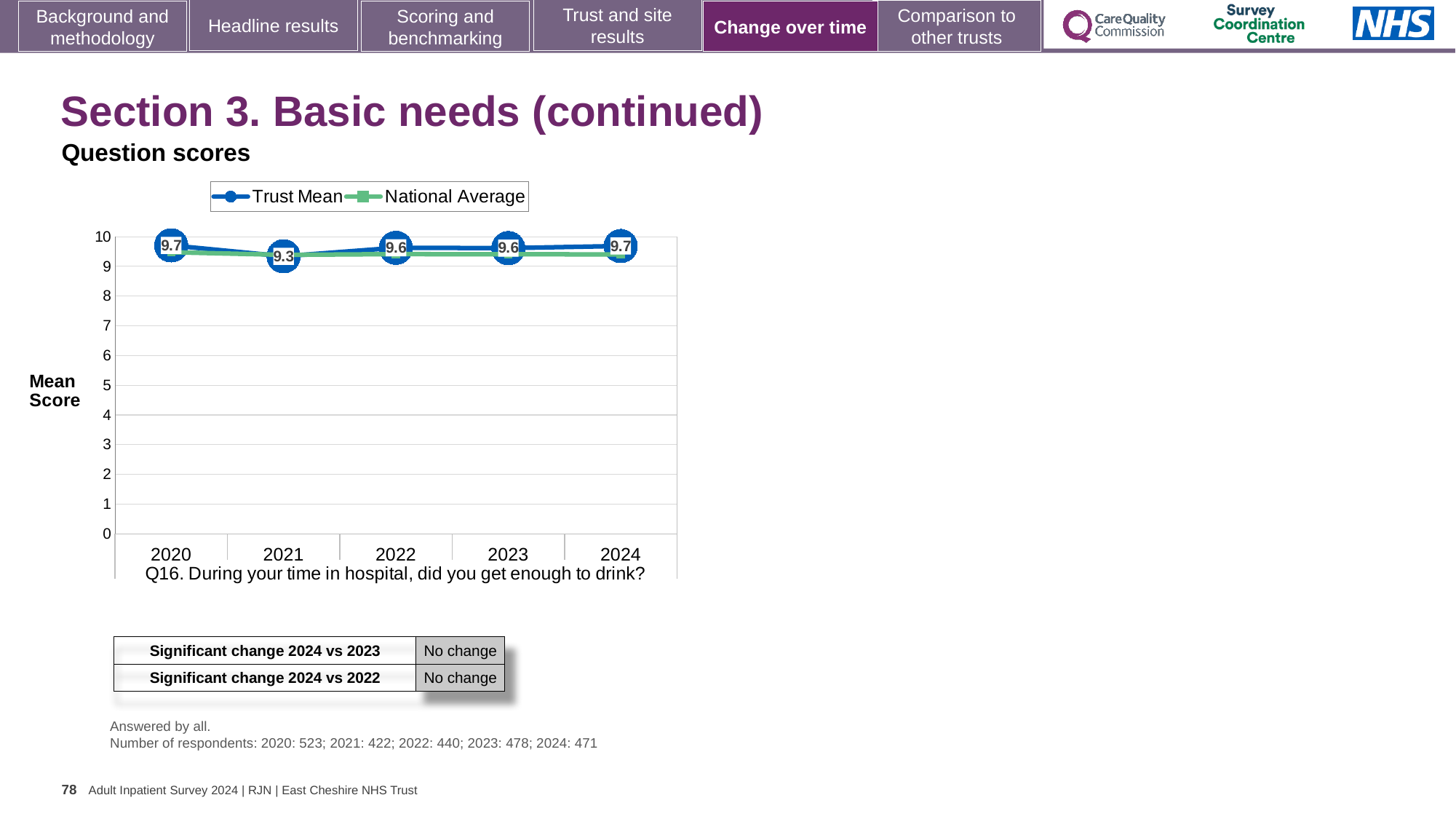
What question does the chart relate to, as shown below the x axis? Q16. During your time in hospital, did you get enough to drink? How many years are plotted on the x axis? 5 What is the Trust Mean score for 2024? 9.7 What is the Trust Mean score for 2021? 9.3 In which year is the Trust Mean score lowest? 2021 What is the Trust Mean score for 2022? 9.6 Does the Trust Mean score rise or fall from 2021 to 2024? Rise How many series does the legend list? 2 What kind of chart is shown? Line chart What is the difference between the Trust Mean scores for 2020 and 2021? 0.4 Is the National Average value for 2023 greater or less than 9? greater Which year has the higher Trust Mean score, 2021 or 2022? 2022